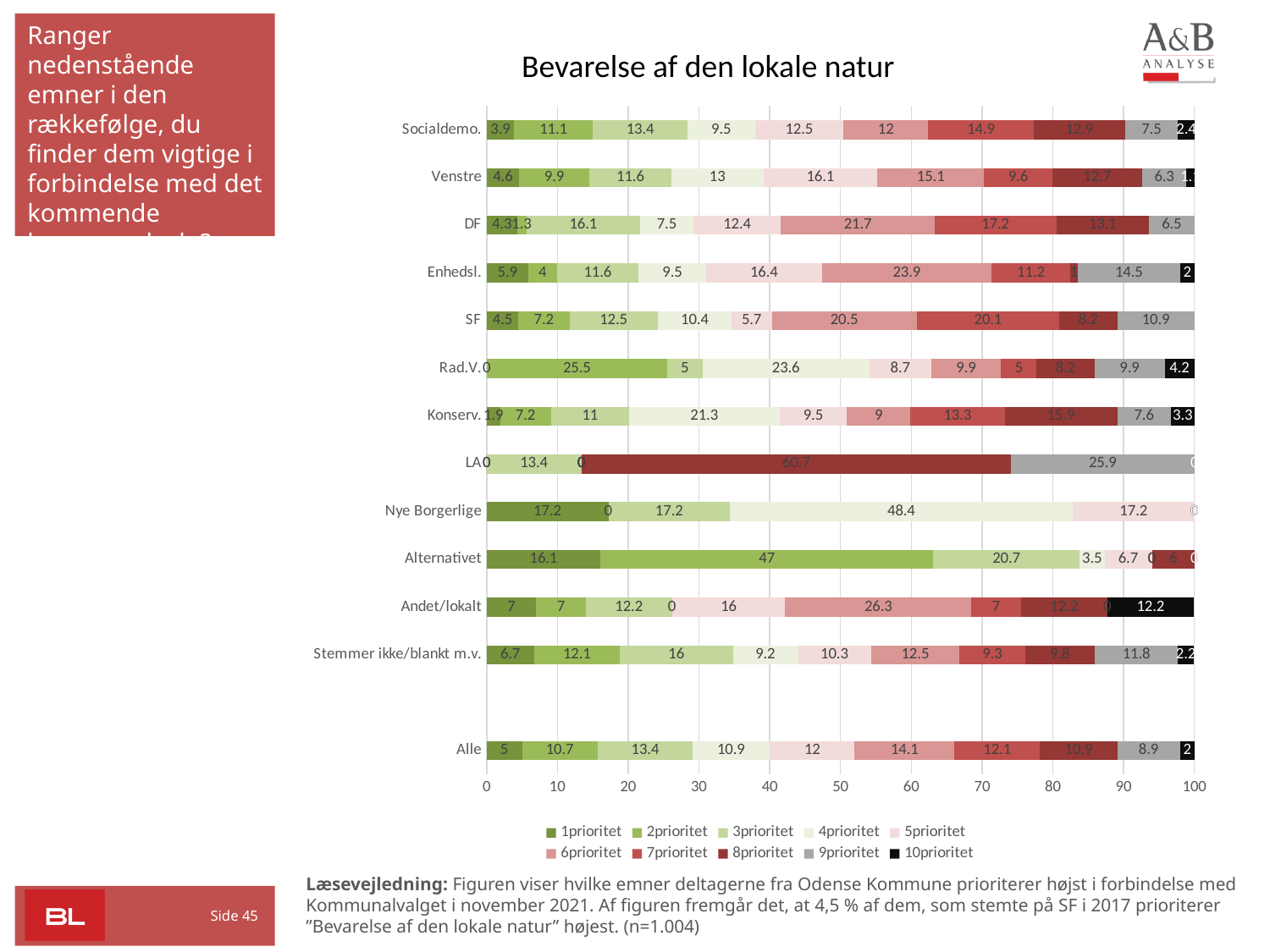
How many series does the legend list? 10 Which has the larger 5prioritet value, Venstre or Socialdemo.? Venstre How many categories are plotted on the y axis? 13 What is the title of the chart? Bevarelse af den lokale natur What is the 1prioritet value for SF? 4.5 What is the 1prioritet value for Alle? 5 What kind of chart is shown on the slide? bar chart What is the 7prioritet value for LA? 0 Which category has the highest 1prioritet value? Nye Borgerlige What is the 4prioritet value for Nye Borgerlige? 48.4 What is the difference between the 2prioritet and 1prioritet values for Alle? 5.7 What is the 2prioritet value for Alternativet? 47